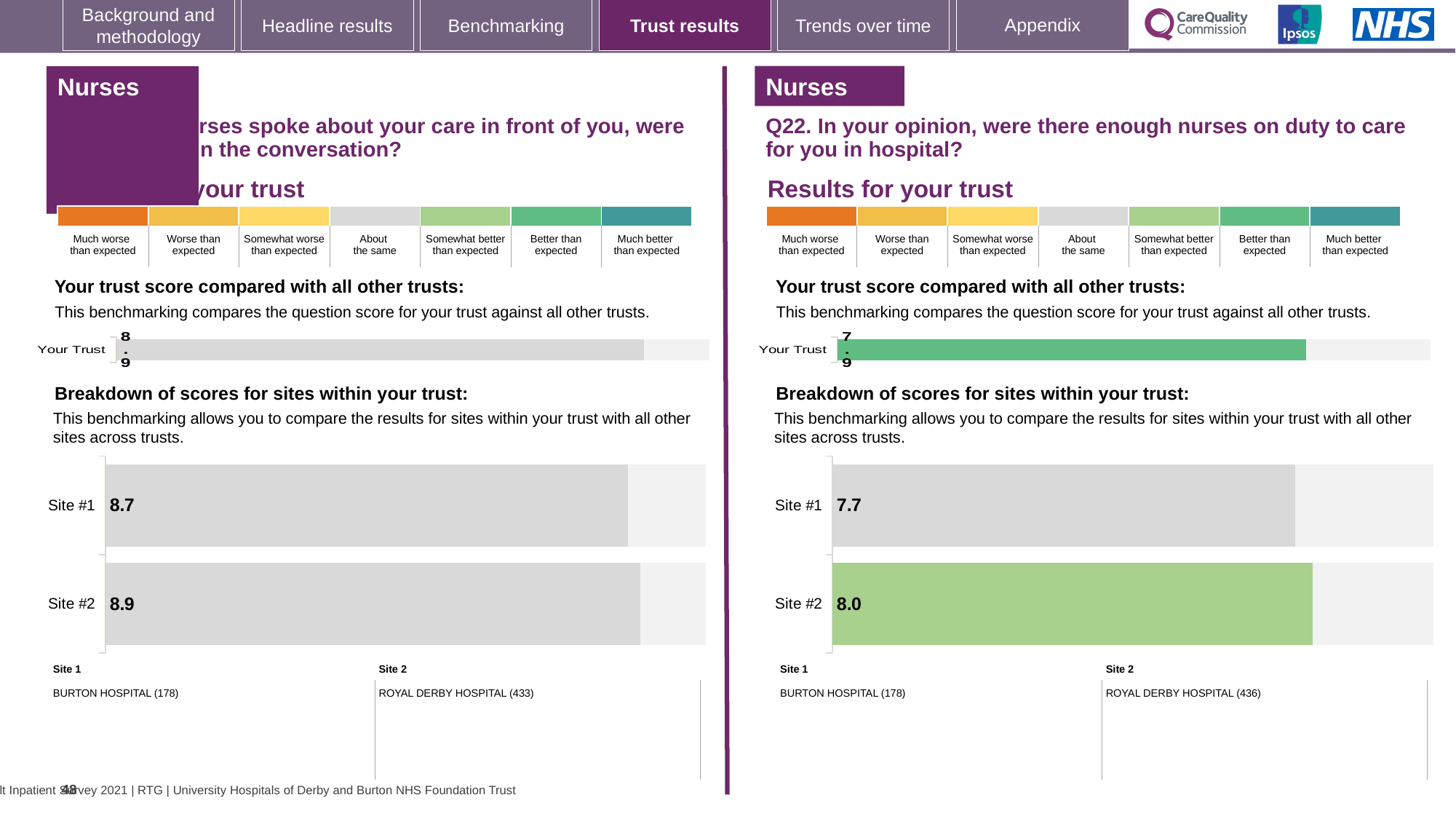
How many sites are shown on the right-hand (Q22) site breakdown chart? 2 On the left-hand site breakdown chart, what is the score for Site #1? 8.7 On the left-hand site breakdown chart, which site has the lower score? Site #1 On the right-hand (Q22) site breakdown chart, what is the difference between the Site #2 and Site #1 scores? 0.3 On the right-hand (Q22) 'Your trust score compared with all other trusts' chart, what is the score for Your Trust? 7.9 On the left-hand site breakdown chart, what is the score for Site #2? 8.9 On the right-hand (Q22) site breakdown chart, what is the score for Site #1? 7.7 On the right-hand (Q22) site breakdown chart, what is the score for Site #2? 8.0 On the left-hand 'Your trust score compared with all other trusts' chart, what is the score for Your Trust? 8.9 What type of chart is the right-hand (Q22) site breakdown chart? Bar chart On the right-hand (Q22) site breakdown chart, which site has the higher score? Site #2 On the left-hand site breakdown chart, what is the difference between the Site #2 and Site #1 scores? 0.2